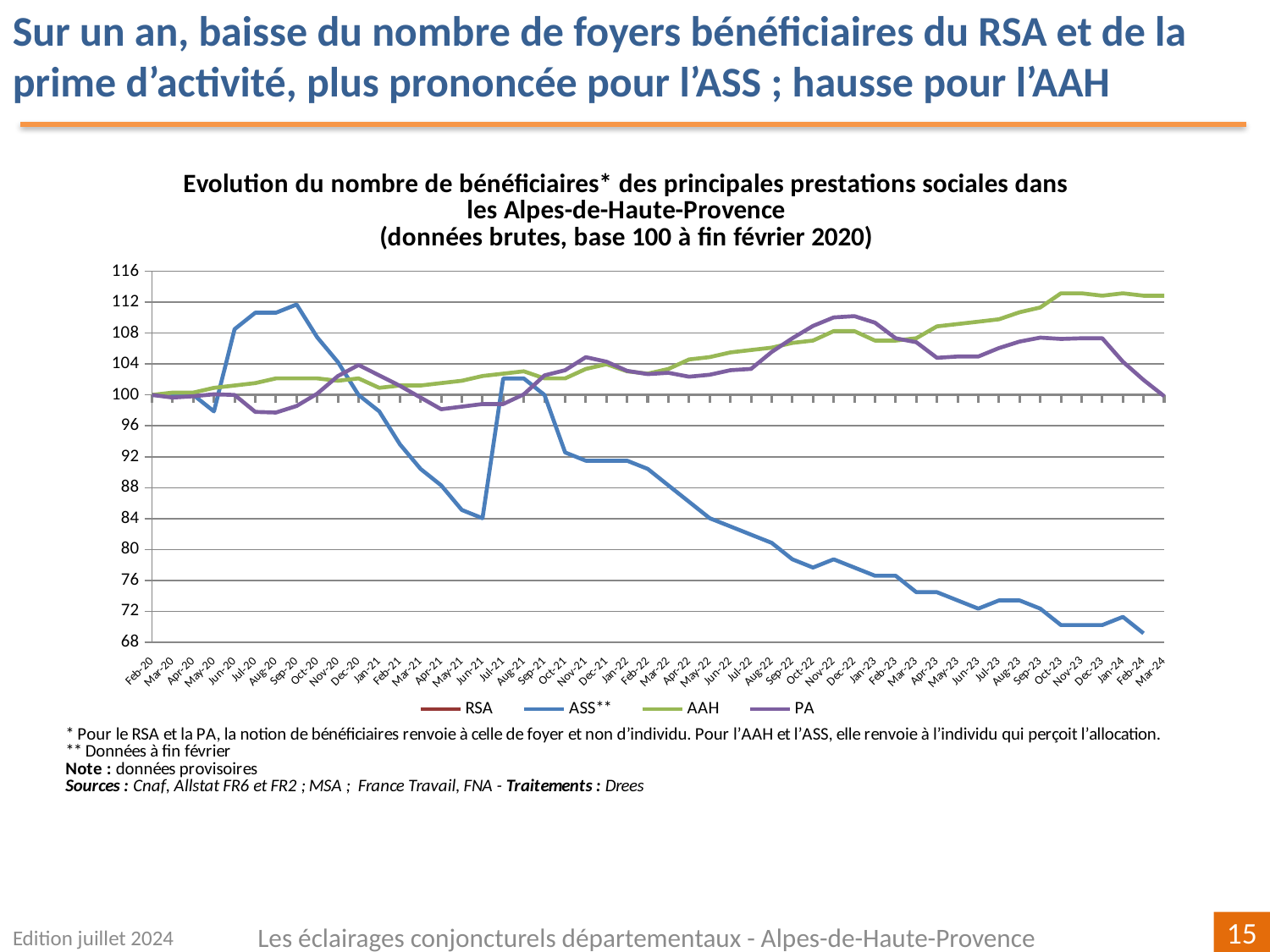
Does the AAH series generally rise or fall from Feb-20 to Mar-24? rise Is the value of the ASS** series at Sep-20 greater or less than 108? greater What is the value of the AAH series at Feb-20? 100 Is the value of the AAH series at Mar-24 greater or less than 112? greater At Sep-20, which series has the larger value, ASS** or AAH? ASS** What type of chart is shown on the slide? line chart Which series has the highest value at Mar-24? AAH Is the value of the PA series at Nov-22 greater or less than 108? greater How many series does the legend list? 4 Does the ASS** series generally rise or fall from Sep-20 to Mar-24? fall